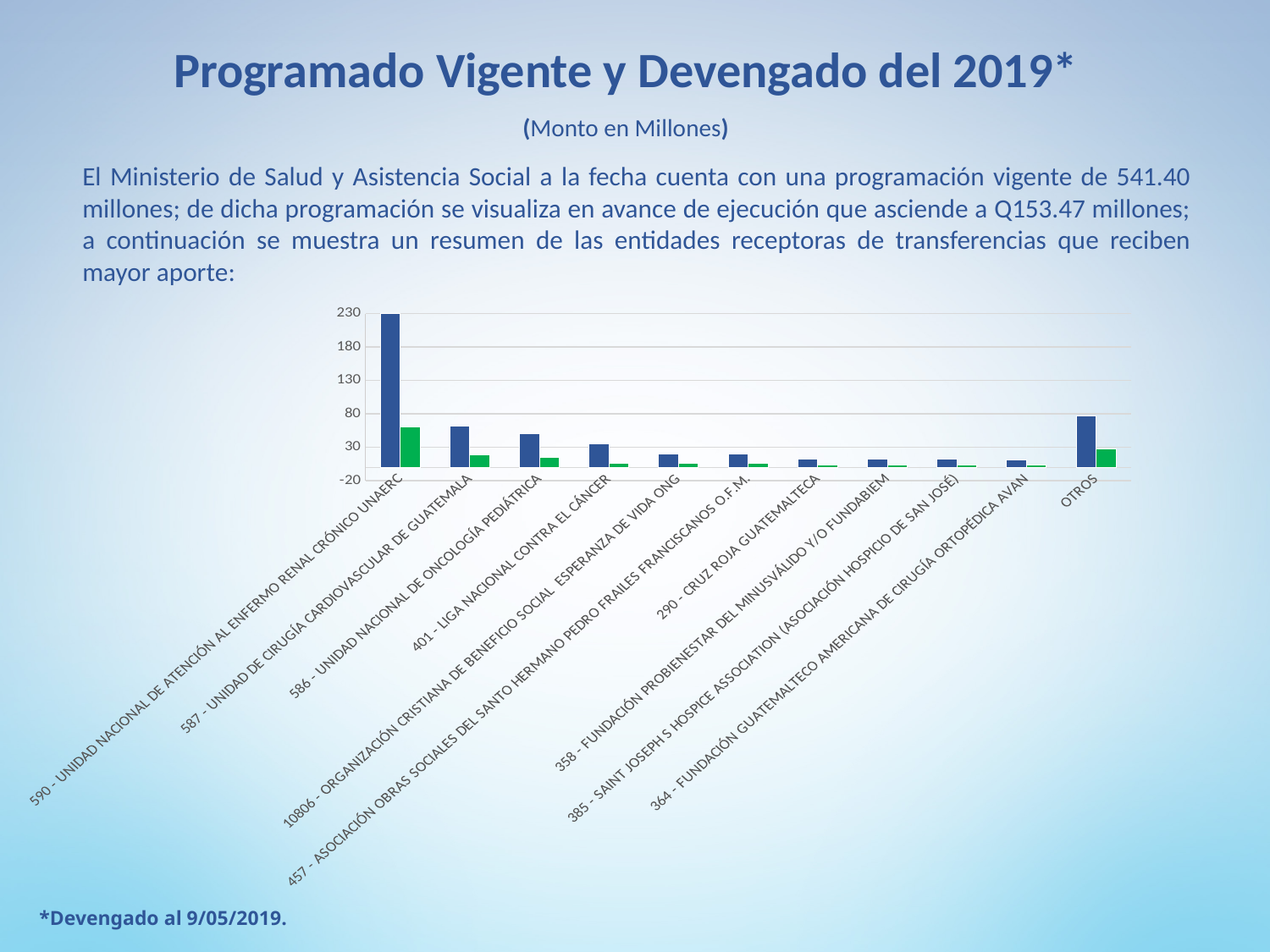
Is the blue bar for OTROS greater or less than 30? greater Is the green bar for 590 - UNIDAD NACIONAL DE ATENCIÓN AL ENFERMO RENAL CRÓNICO UNAERC greater or less than 30? greater Which category has the tallest blue bar? 590 - UNIDAD NACIONAL DE ATENCIÓN AL ENFERMO RENAL CRÓNICO UNAERC What kind of chart is shown on the slide? bar chart Is the blue bar for 587 - UNIDAD DE CIRUGÍA CARDIOVASCULAR DE GUATEMALA greater or less than 80? less What is the label of the last category on the x axis? OTROS Excluding the OTROS category, do the blue bars generally rise or fall from left to right along the x axis? fall Which has the taller green bar: 590 - UNIDAD NACIONAL DE ATENCIÓN AL ENFERMO RENAL CRÓNICO UNAERC or 290 - CRUZ ROJA GUATEMALTECA? 590 - UNIDAD NACIONAL DE ATENCIÓN AL ENFERMO RENAL CRÓNICO UNAERC What is the title of the slide containing the chart? Programado Vigente y Devengado del 2019* How many categories are shown along the x axis of the chart? 11 Which has the taller blue bar: 587 - UNIDAD DE CIRUGÍA CARDIOVASCULAR DE GUATEMALA or 401 - LIGA NACIONAL CONTRA EL CÁNCER? 587 - UNIDAD DE CIRUGÍA CARDIOVASCULAR DE GUATEMALA